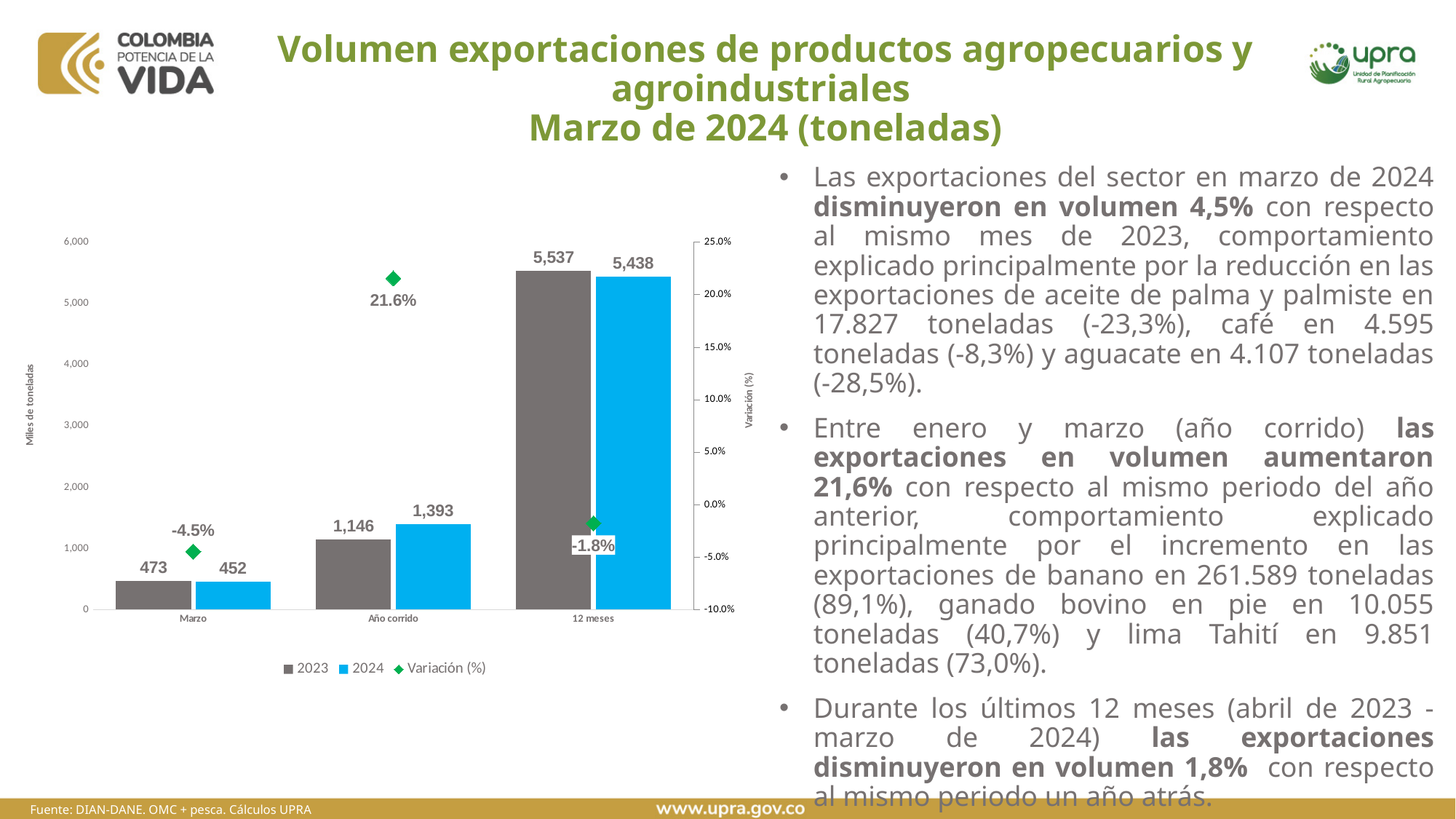
What is the difference between the 2023 and 2024 values in the 12 meses category? 99 What is the label of the left vertical axis? Miles de toneladas What is the value for 2024 in the Año corrido category? 1,393 Which category has the lowest value for the 2023 series? Marzo What kind of chart is shown on the slide? Bar chart with a line/marker series What is the Variación (%) value shown for the Año corrido category? 21.6% In the Año corrido category, which series has the larger value, 2023 or 2024? 2024 What is the value for 2023 in the Marzo category? 473 What is the Variación (%) value shown for the 12 meses category? -1.8% How many series does the legend list? 3 Which category has the highest value for the 2024 series? 12 meses How many categories are shown on the x axis? 3